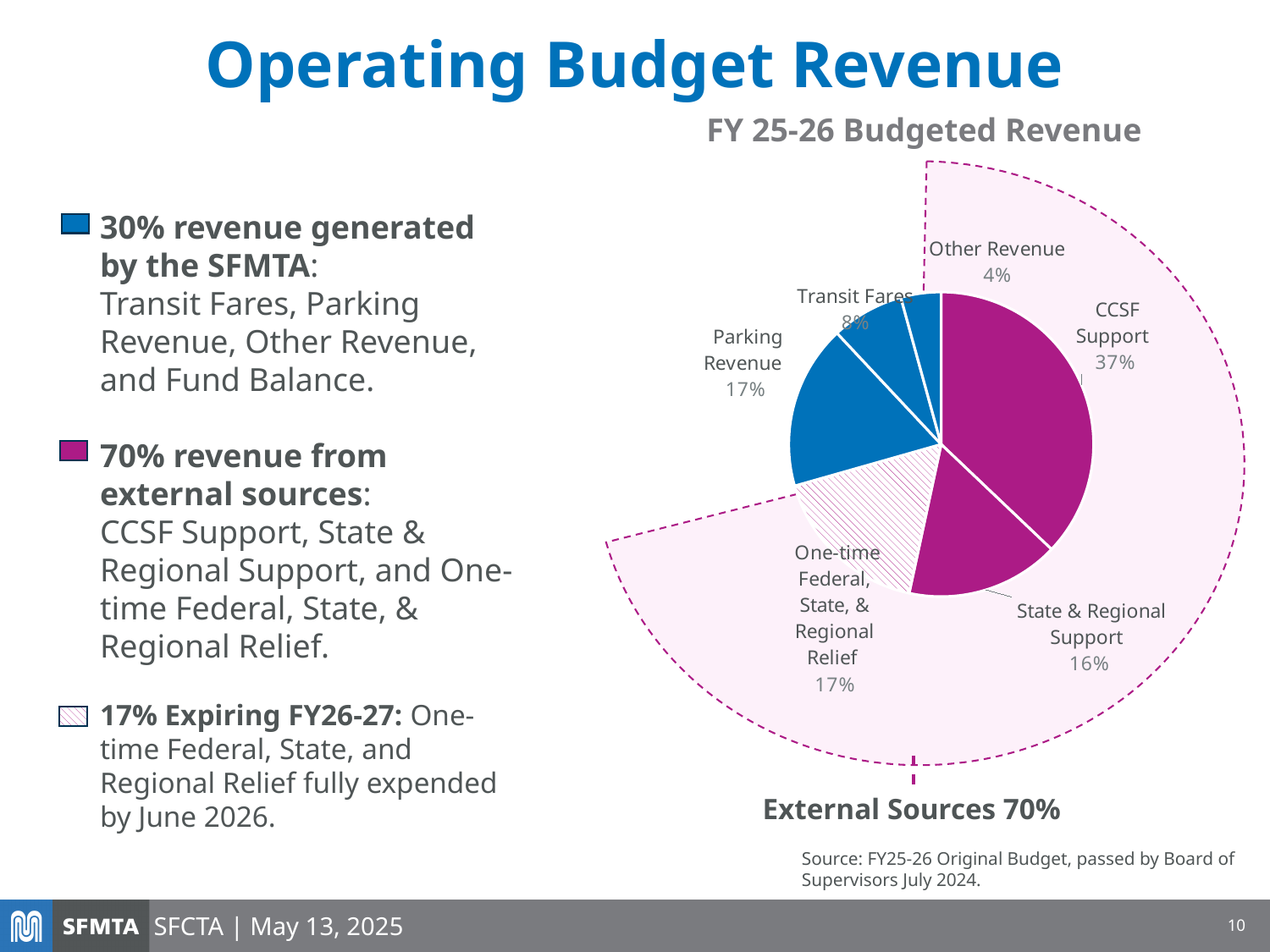
Which slice of the pie chart is the largest? CCSF Support How many slices does the pie chart have? 6 What share of FY 25-26 budgeted revenue comes from Transit Fares? 8% What is the title of the chart? FY 25-26 Budgeted Revenue According to the chart, what percentage of revenue comes from External Sources? 70% Which is larger, Parking Revenue or Transit Fares? Parking Revenue What is the difference in percentage points between CCSF Support and State & Regional Support? 21 Which slice of the pie chart is the smallest? Other Revenue What share of FY 25-26 budgeted revenue comes from CCSF Support? 37% What share of FY 25-26 budgeted revenue comes from State & Regional Support? 16% What share of FY 25-26 budgeted revenue comes from Other Revenue? 4% What type of chart is shown on the slide? pie chart